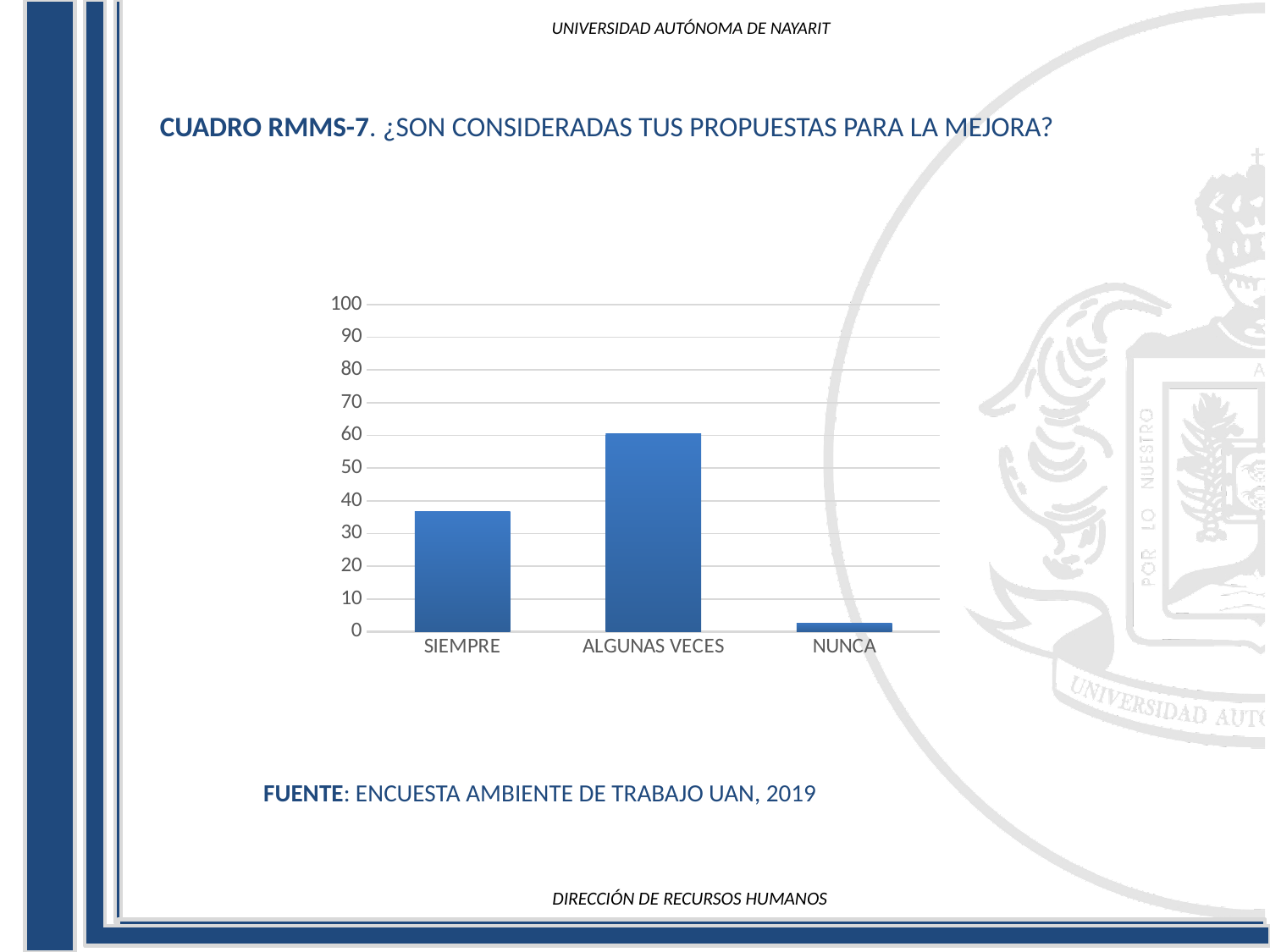
Is the value for NUNCA greater or less than 10? less Is the value for ALGUNAS VECES greater or less than 70? less Is the value for ALGUNAS VECES greater or less than 50? greater How many categories are shown on the x axis of the chart? 3 Which category has the highest bar in the chart? ALGUNAS VECES What kind of chart is shown on the slide? bar chart Which category has the lowest bar in the chart? NUNCA Which is larger, the value for SIEMPRE or the value for ALGUNAS VECES? ALGUNAS VECES Which is larger, the value for SIEMPRE or the value for NUNCA? SIEMPRE What is the source cited below the chart? ENCUESTA AMBIENTE DE TRABAJO UAN, 2019 What is the maximum value shown on the y axis of the chart? 100